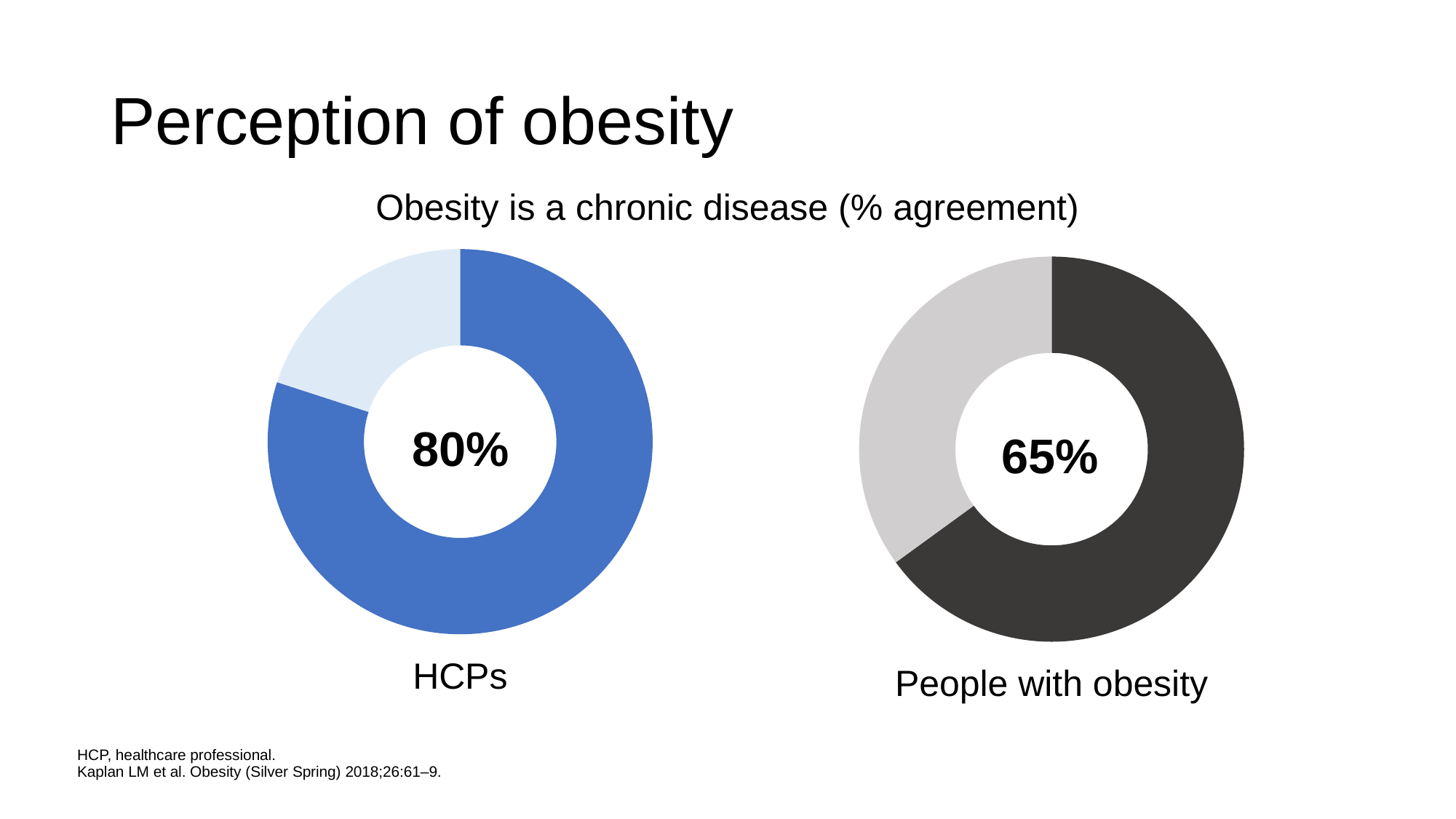
What kind of chart is used to show the HCPs agreement? Doughnut (pie) chart In the HCPs chart, what share of the ring is filled by the dark blue segment? 80% What colour is the agreement segment in the HCPs chart? Blue Which group shows higher agreement that obesity is a chronic disease, HCPs or people with obesity? HCPs How many doughnut charts are shown on the slide? 2 What is the shared title above the two charts? Obesity is a chronic disease (% agreement) Which chart shows the lower percentage agreement? People with obesity What is the difference in percentage agreement between the HCPs chart and the People with obesity chart? 15% What percentage of HCPs agree that obesity is a chronic disease, according to the HCPs chart? 80% In the People with obesity chart, what share of the ring is filled by the dark grey segment? 65% What percentage of people with obesity agree that obesity is a chronic disease, according to the People with obesity chart? 65%